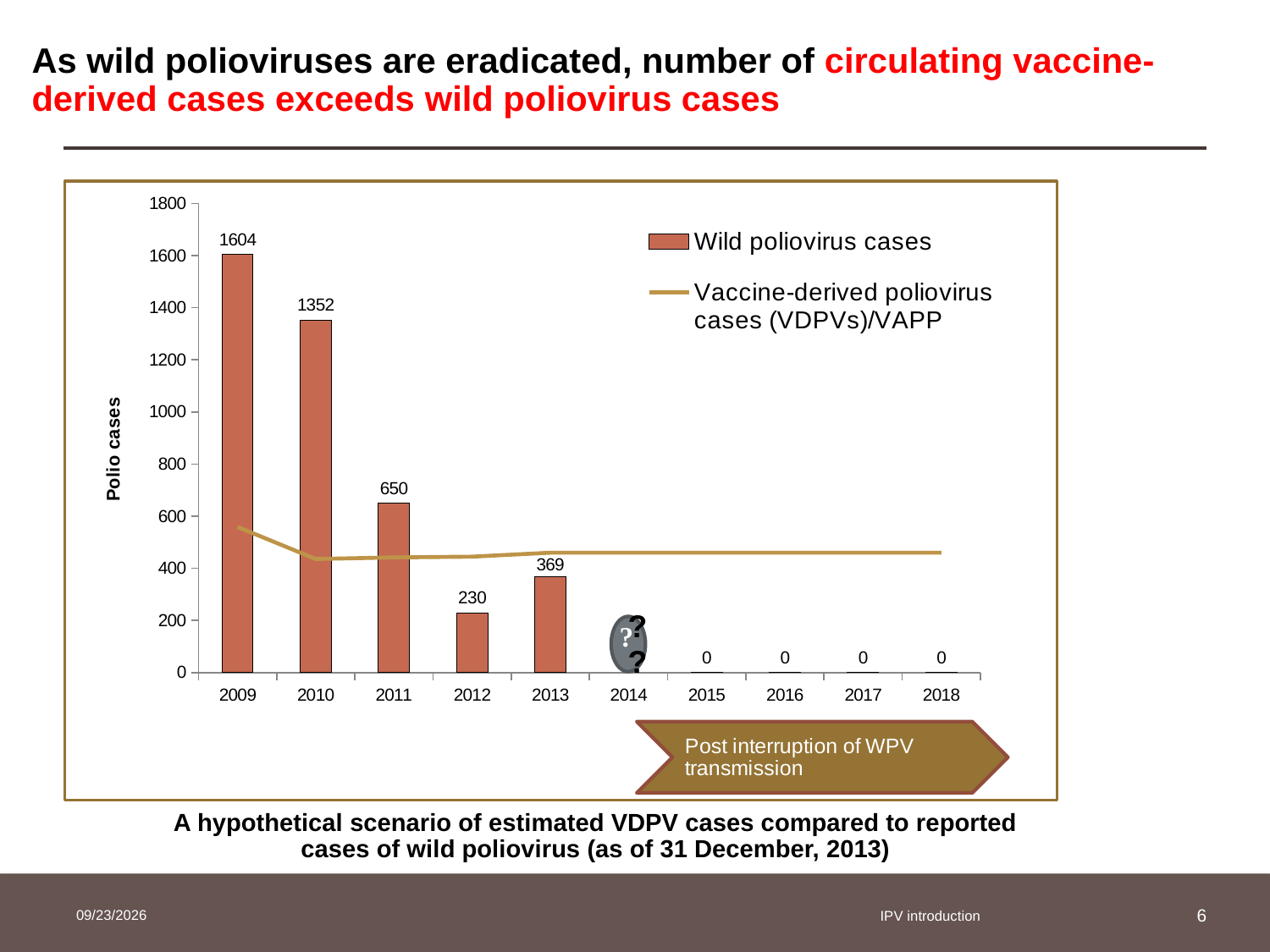
Which year has the highest number of wild poliovirus cases? 2009 How many years are shown on the x axis? 10 What value is labelled on the wild poliovirus bar for 2013? 369 What is the number of wild poliovirus cases in 2011? 650 What is the wild poliovirus case count shown for 2016? 0 Which year has more wild poliovirus cases, 2012 or 2013? 2013 Among the years 2009 to 2013, which year has the lowest number of wild poliovirus cases? 2012 How many wild poliovirus cases are shown for 2009? 1604 What is the difference between wild poliovirus cases in 2009 and 2010? 252 Is the value of the vaccine-derived poliovirus cases line in 2009 greater or less than 400? greater How many series does the legend list? 2 What is the label on the y axis? Polio cases